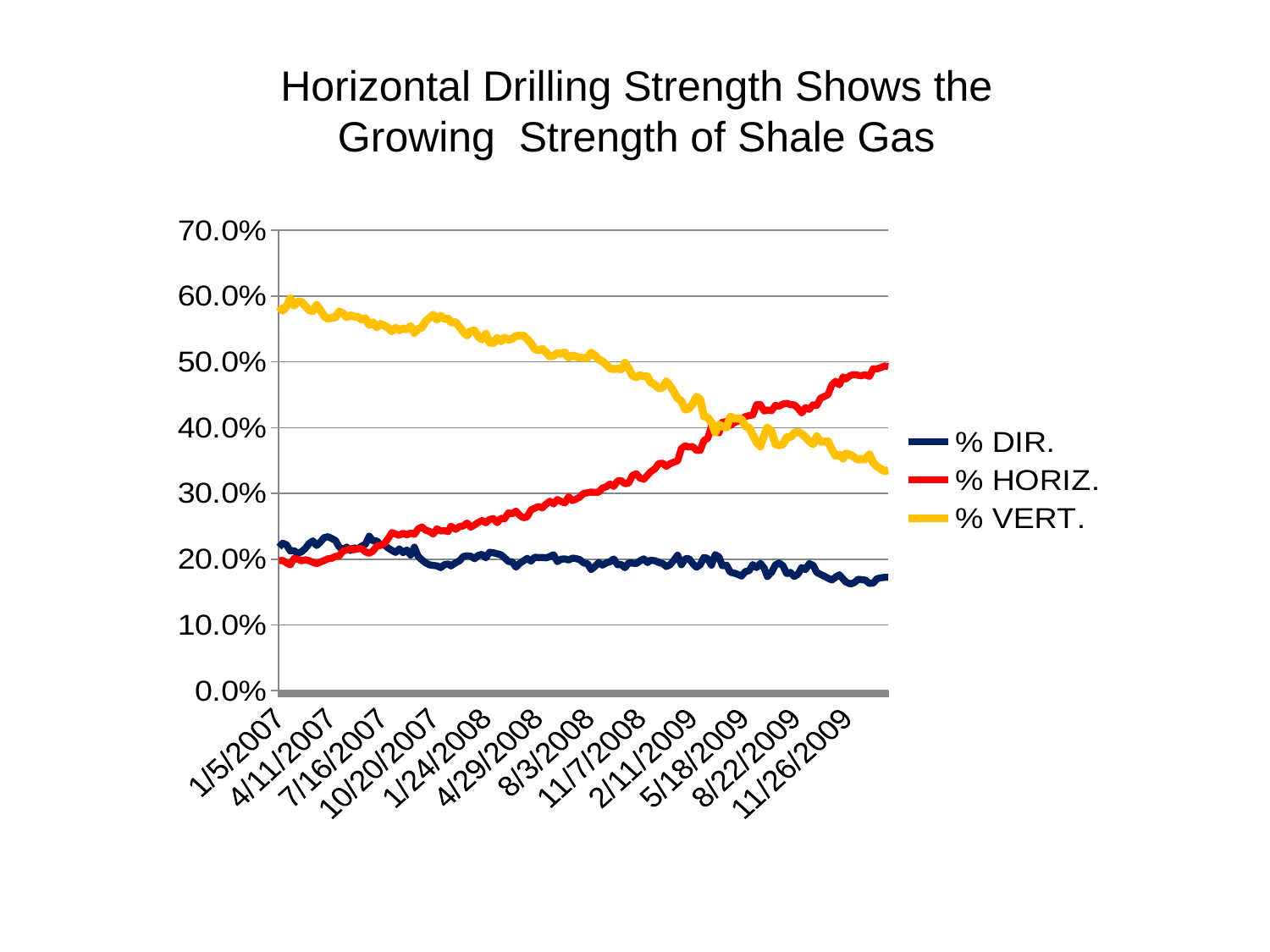
Which series are listed in the legend? % DIR., % HORIZ., % VERT. Does the % VERT. line rise or fall from 1/5/2007 to 11/26/2009? fall Is the value for % HORIZ. at the end of the series (late 2009) greater or less than 40.0%? greater Is the value for % VERT. at 1/5/2007 greater or less than 50.0%? greater Is the value for % DIR. at the end of the series (late 2009) greater or less than 20.0%? less What colour is the % HORIZ. line? red At the end of the series (late 2009), which is larger: % HORIZ. or % VERT.? % HORIZ. What kind of chart is shown on the slide? line chart How many series does the legend list? 3 At 1/5/2007, which is larger: % VERT. or % HORIZ.? % VERT. Does the % HORIZ. line rise or fall from 1/5/2007 to 11/26/2009? rise